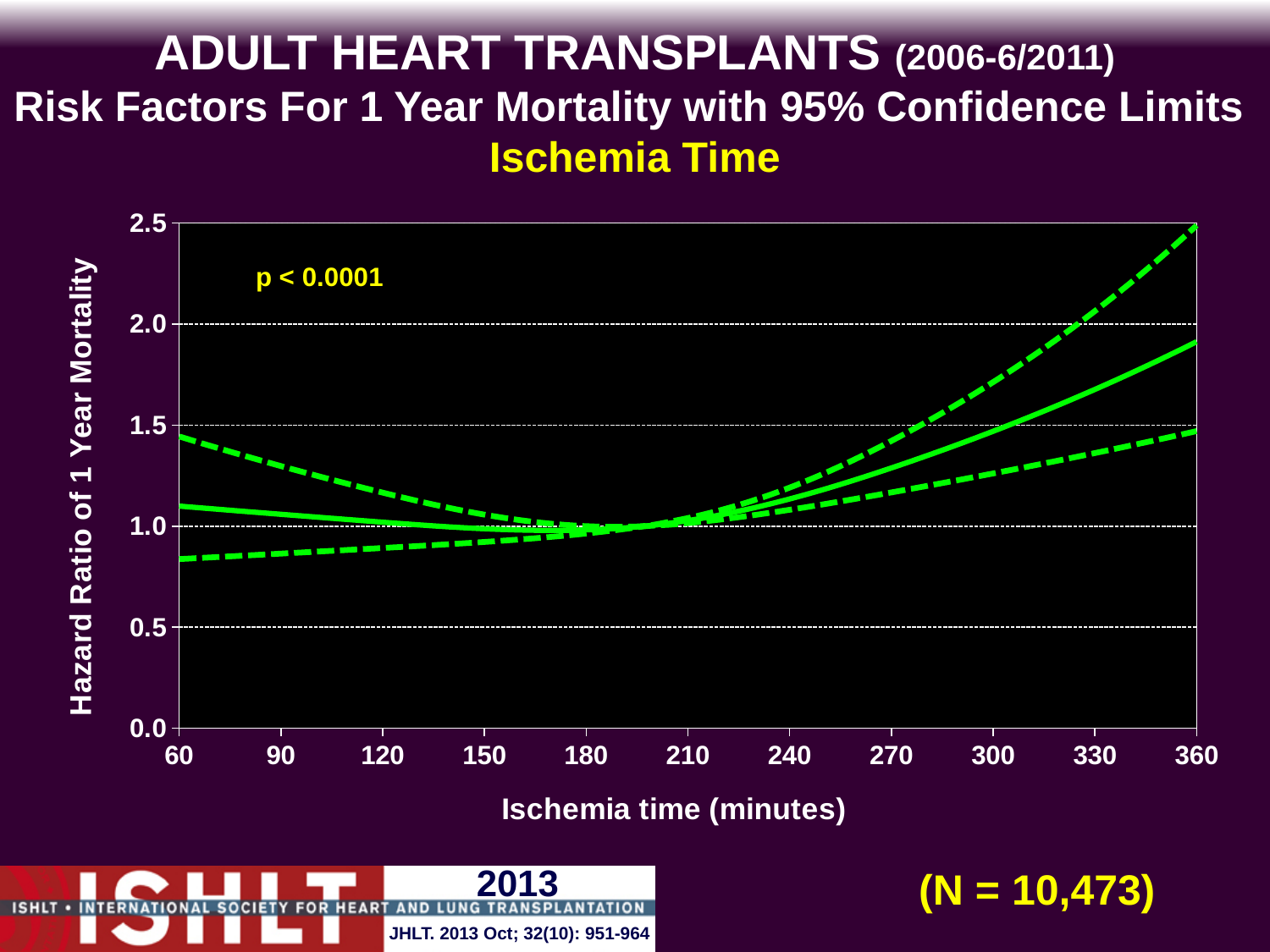
What p-value is printed on the chart? p < 0.0001 Is the value of the upper dashed confidence limit line at 60 minutes greater or less than 1.0? greater Is the value of the upper dashed confidence limit line at 360 minutes greater or less than 2.0? greater Is the value of the lower dashed confidence limit line at 360 minutes greater or less than 1.0? greater How many tick labels are shown on the x axis? 11 What is the label of the x axis? Ischemia time (minutes) Does the solid hazard ratio line rise or fall between 210 and 360 minutes of ischemia time? rise Does the upper dashed confidence limit line rise or fall between 60 and 180 minutes of ischemia time? fall What kind of chart is shown on the slide? line chart How many lines are plotted on the chart? 3